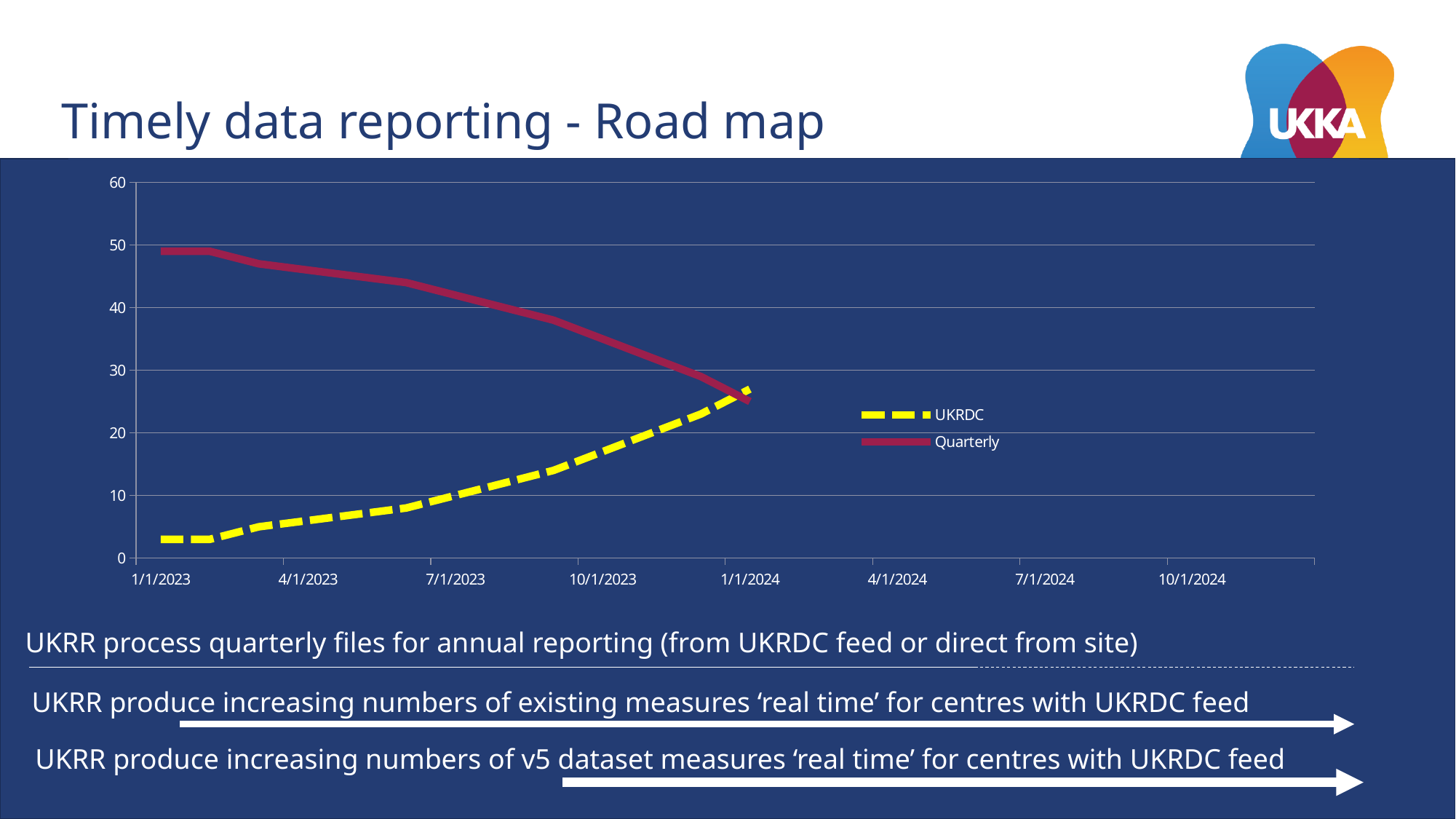
Is the value for Quarterly at 1/1/2024 greater or less than 30? less At 1/1/2023, which series has the higher value, UKRDC or Quarterly? Quarterly How many date labels are shown on the x axis? 8 Is the value for UKRDC at 1/1/2023 greater or less than 10? less How many series does the legend list? 2 What kind of chart is shown on the slide? line chart Is the value for Quarterly at 1/1/2023 greater or less than 40? greater Does the UKRDC series rise or fall from 1/1/2023 to 1/1/2024? rise Which two series are listed in the legend? UKRDC and Quarterly Does the Quarterly series rise or fall from 1/1/2023 to 1/1/2024? fall Which series is drawn as a yellow dashed line? UKRDC